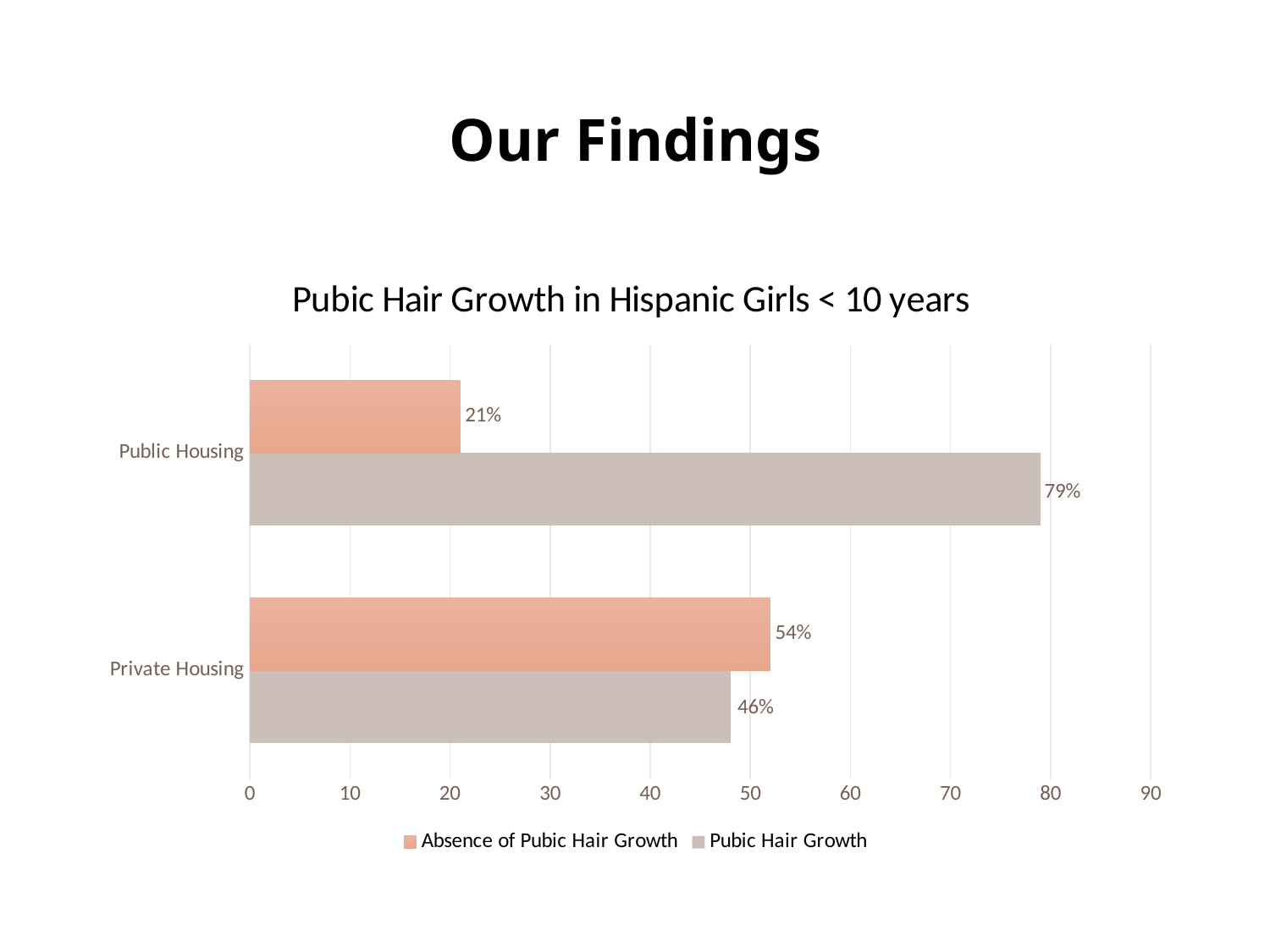
What is the value for Absence of Pubic Hair Growth in Public Housing? 21% What kind of chart is shown on the slide? Bar chart Which housing category has the highest value for Pubic Hair Growth? Public Housing What is the title of the chart? Pubic Hair Growth in Hispanic Girls < 10 years What is the value for Pubic Hair Growth in Private Housing? 46% In Private Housing, which is larger: Absence of Pubic Hair Growth or Pubic Hair Growth? Absence of Pubic Hair Growth Which housing category has the lowest value for Absence of Pubic Hair Growth? Public Housing What is the value for Pubic Hair Growth in Public Housing? 79% What is the difference between Pubic Hair Growth and Absence of Pubic Hair Growth in Public Housing? 58% How many series does the legend list? 2 How many housing categories are shown on the chart? 2 What is the value for Absence of Pubic Hair Growth in Private Housing? 54%